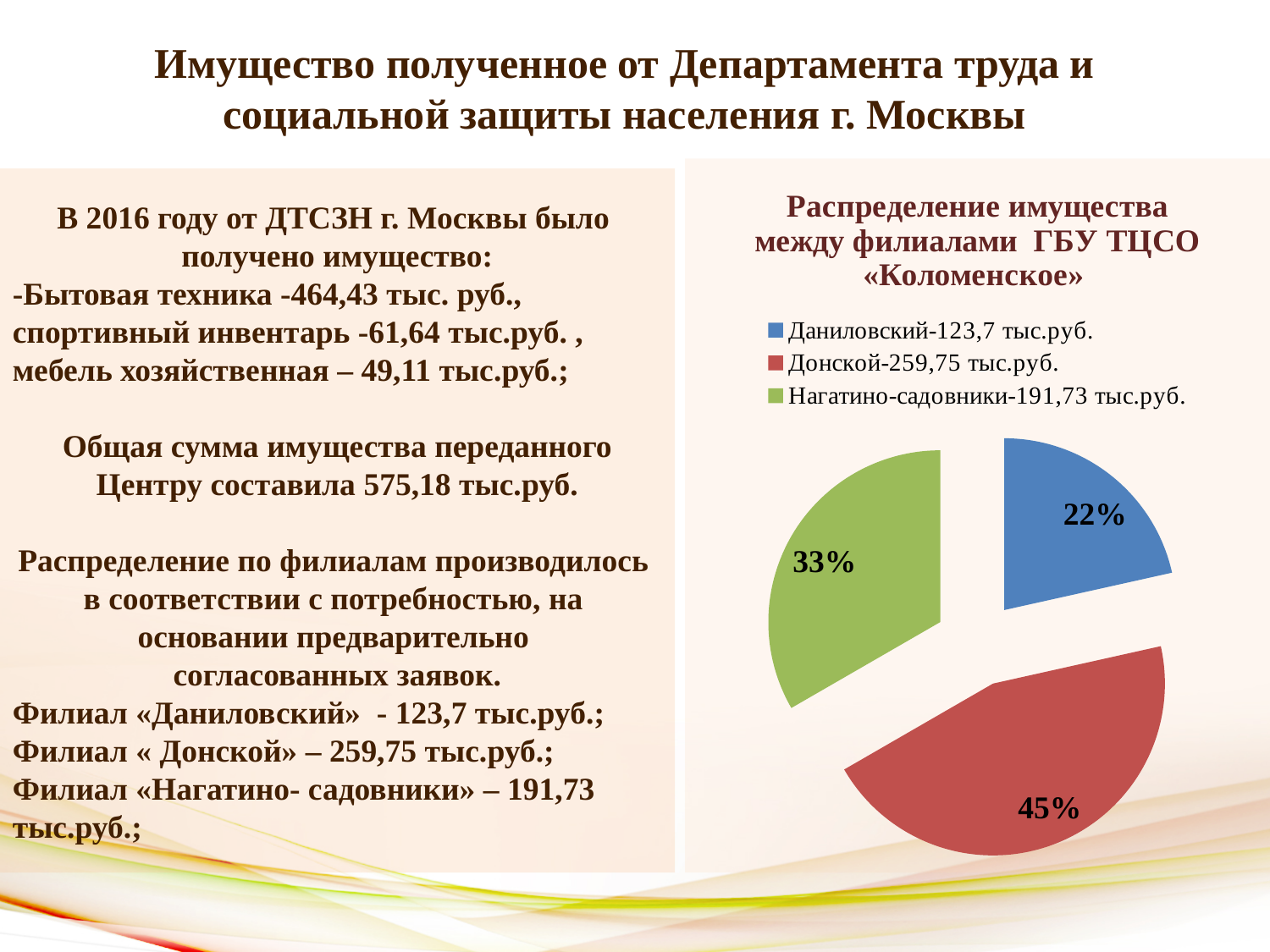
By how many percentage points does the Донской slice exceed the Даниловский slice? 23 percentage points Which branch has the largest slice of the pie? Донской How many slices does the pie chart have? 3 What share of the pie does the Нагатино-садовники branch have? 33% What kind of chart is shown on the slide? Pie chart Which branch has the smallest slice of the pie? Даниловский How many entries does the legend of the pie chart list? 3 Which slice is larger, Нагатино-садовники or Даниловский? Нагатино-садовники What share of the pie does the Донской branch have? 45% What colour is the slice for the Донской branch? Red What share of the pie does the Даниловский branch have? 22% What is the title of the pie chart? Распределение имущества между филиалами ГБУ ТЦСО «Коломенское»